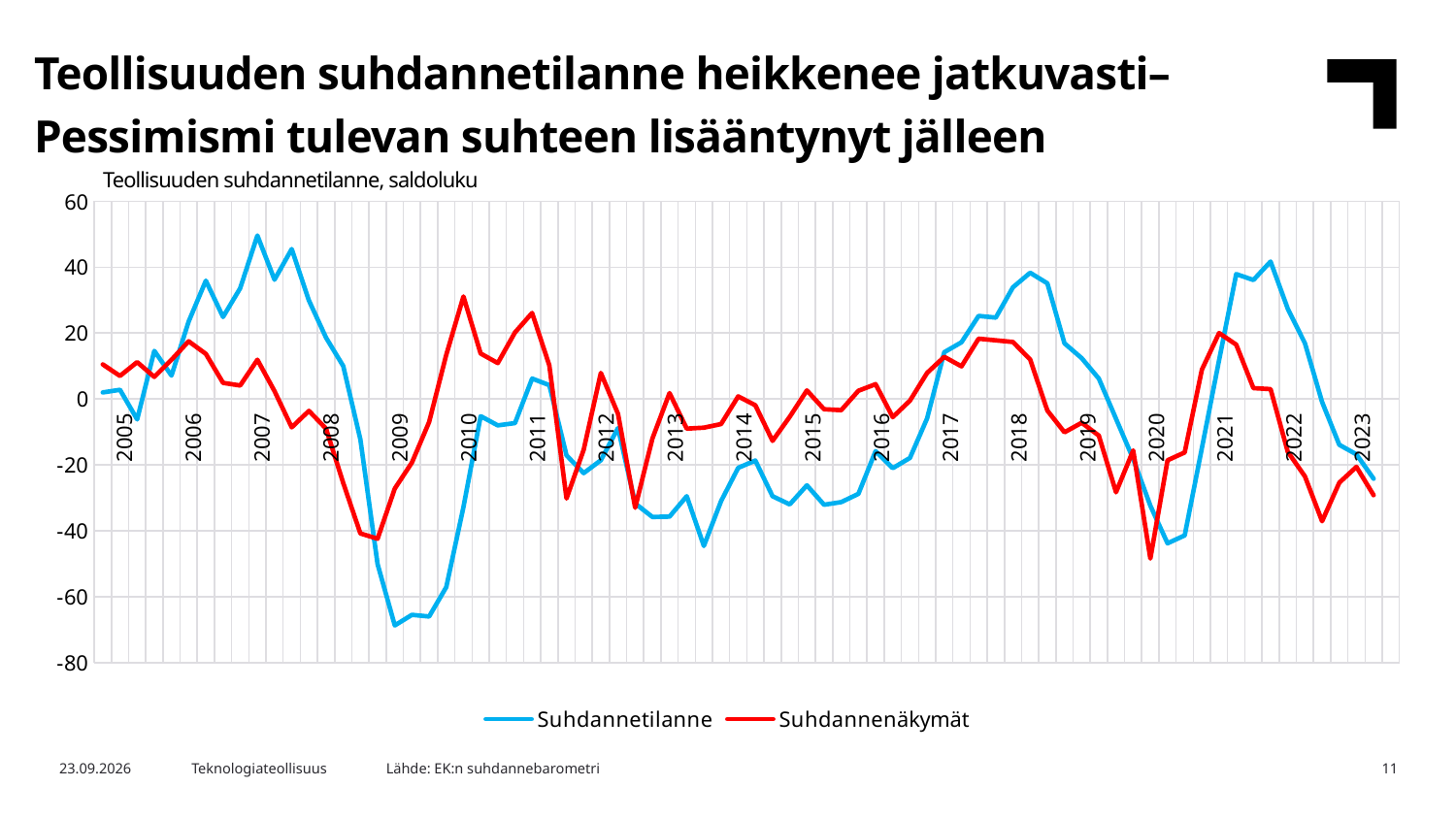
Does the Suhdannetilanne line rise or fall from its 2021 peak to 2023? fall Which series reaches the lowest value anywhere on the chart? Suhdannetilanne Around 2009, which series has the lower value, Suhdannetilanne or Suhdannenäkymät? Suhdannetilanne Which series reaches the highest value anywhere on the chart? Suhdannetilanne What is the title printed above the chart? Teollisuuden suhdannetilanne, saldoluku What kind of chart is shown on the slide? line chart How many series does the legend list? 2 Is the highest value of the Suhdannetilanne line (around 2007) greater or less than 40? greater Is the lowest value of the Suhdannetilanne line (around 2009) greater or less than -60? less Is the peak of the Suhdannenäkymät line around 2010 greater or less than 20? greater What are the two series named in the legend? Suhdannetilanne and Suhdannenäkymät